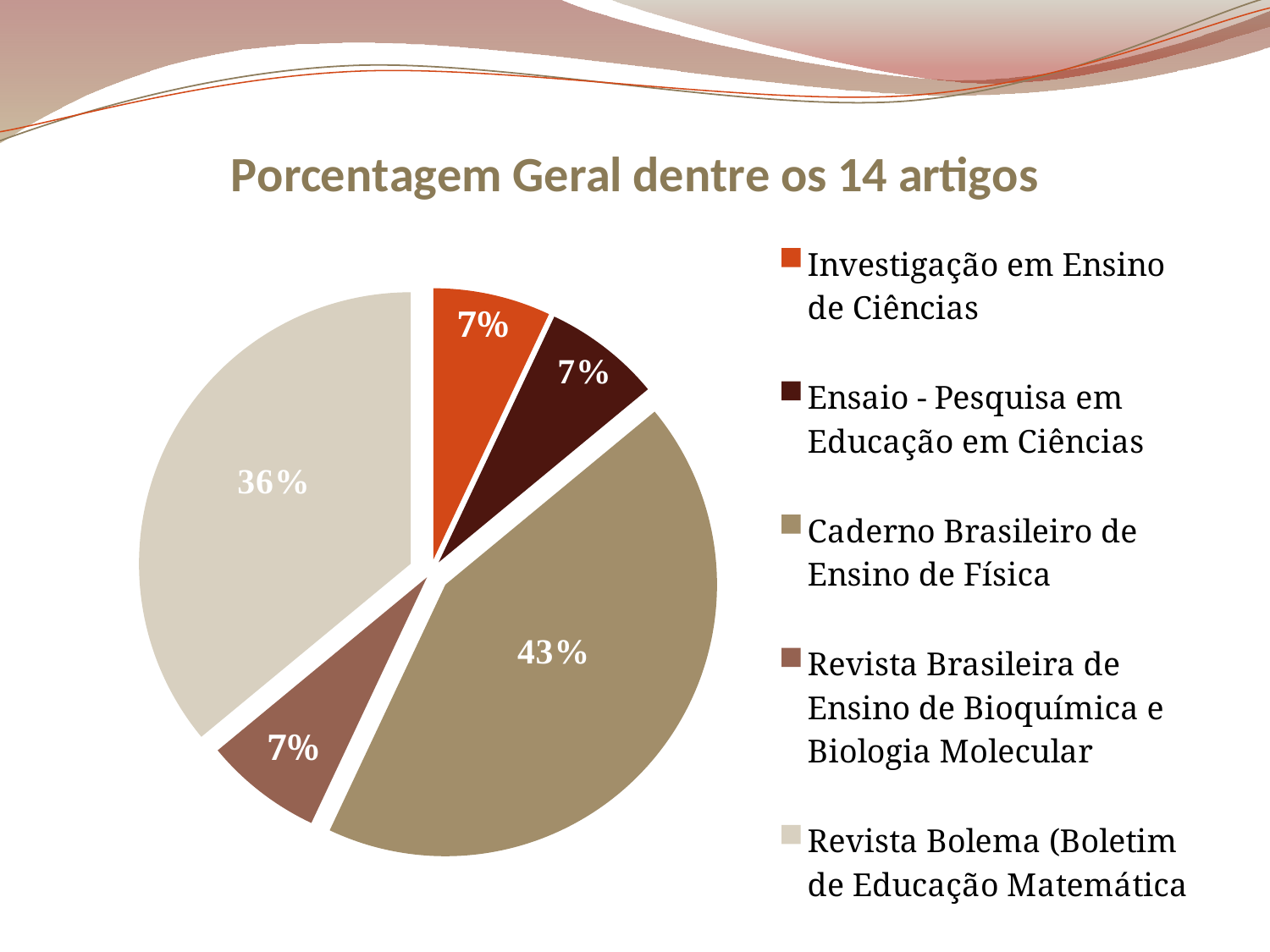
What is the difference between the shares of Caderno Brasileiro de Ensino de Física and Revista Bolema (Boletim de Educação Matemática)? 7% How many slices does the pie chart have? 5 Which category has the largest share of the pie? Caderno Brasileiro de Ensino de Física What share of the pie does Caderno Brasileiro de Ensino de Física have? 43% What is the smallest percentage shown on the pie chart? 7% What is the title of the chart? Porcentagem Geral dentre os 14 artigos What is the value for Revista Brasileira de Ensino de Bioquímica e Biologia Molecular? 7% What share of the pie does Revista Bolema (Boletim de Educação Matemática) have? 36% How many entries does the legend list? 5 What is the value for Investigação em Ensino de Ciências? 7% What kind of chart is shown on the slide? pie chart Which is larger, the share for Revista Bolema (Boletim de Educação Matemática) or the share for Ensaio - Pesquisa em Educação em Ciências? Revista Bolema (Boletim de Educação Matemática)